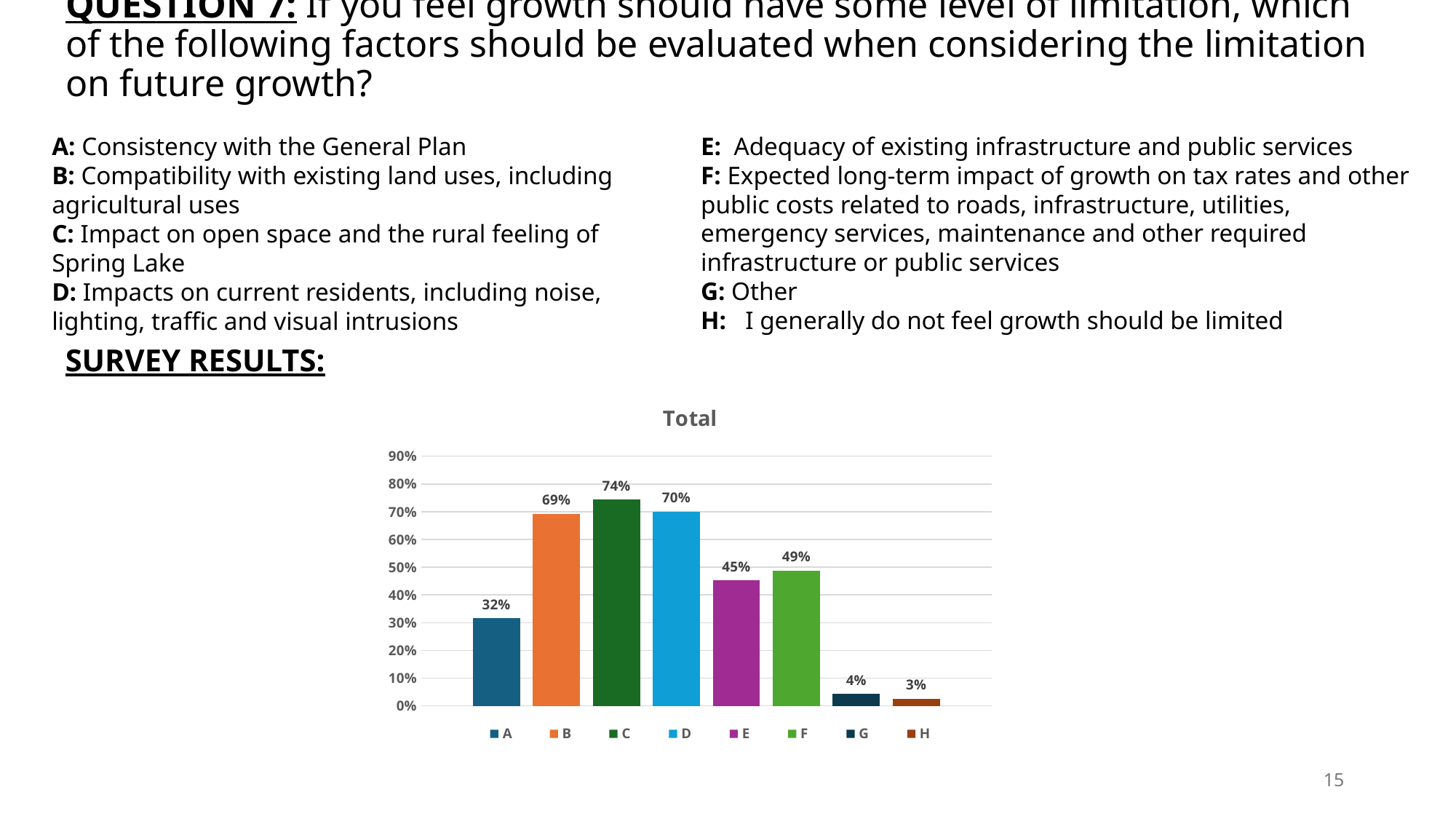
What is the value for F in the chart? 49% What is the highest value shown on the vertical axis of the chart? 90% Is the value for E greater or less than 50%? less Which category has the lowest value in the chart? H What is the title of the chart? Total Which category has the highest value in the chart? C What kind of chart is shown on the slide? bar chart How many categories are shown in the chart? 8 What is the difference between the values for D and E? 25% Which is larger, the value for B or the value for F? B What is the value for A in the chart? 32% What is the value for C in the chart? 74%